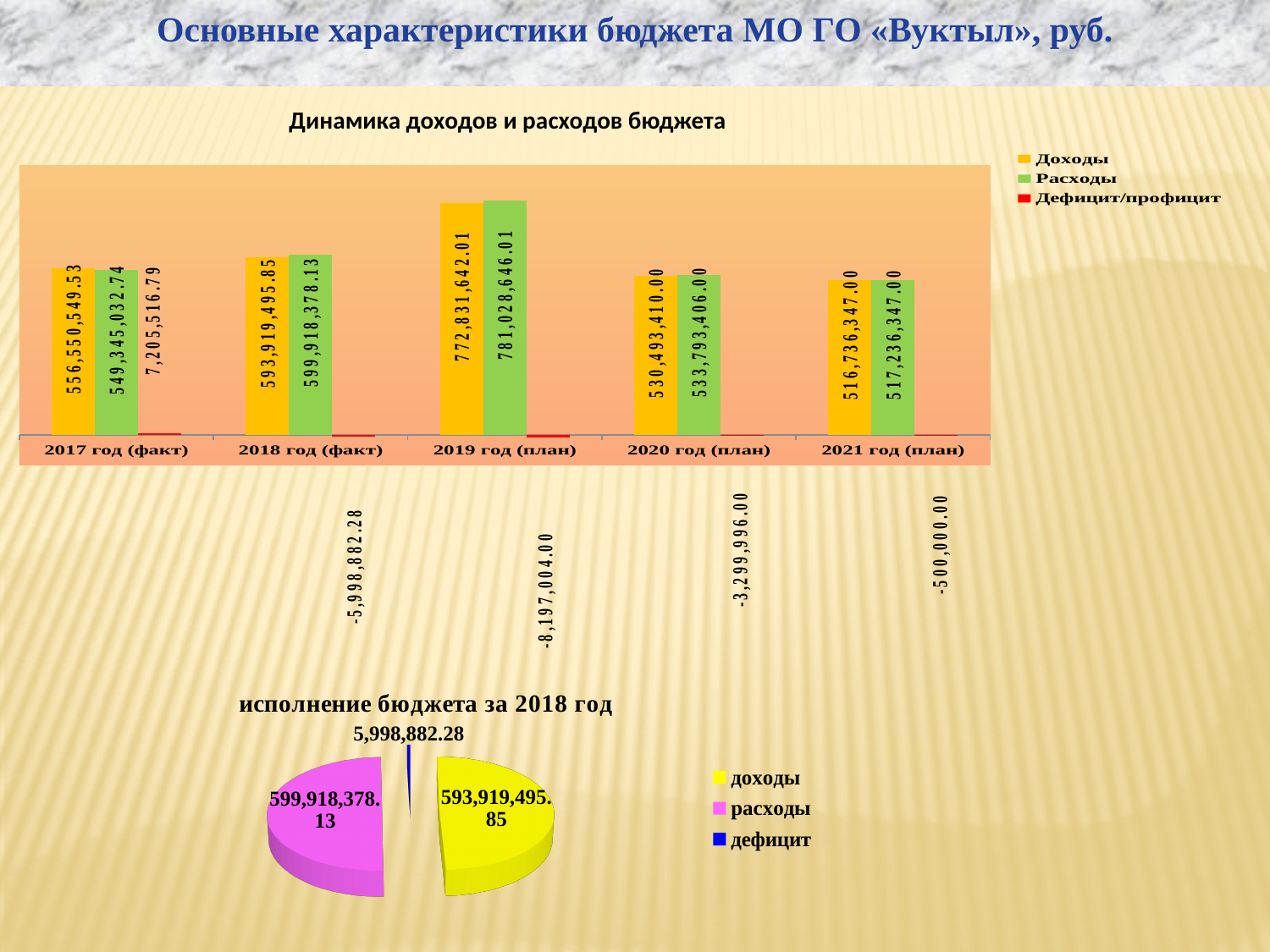
In the chart 'Динамика доходов и расходов бюджета', which year has the lowest Расходы? 2021 год (план) In the pie chart 'исполнение бюджета за 2018 год', what is the value of расходы? 599,918,378.13 What type of chart is 'исполнение бюджета за 2018 год'? pie chart In the chart 'Динамика доходов и расходов бюджета', what is the difference between Расходы and Доходы for 2021 год (план)? 500,000.00 In the chart 'Динамика доходов и расходов бюджета', which year has the highest Доходы? 2019 год (план) How many year categories are shown in the chart 'Динамика доходов и расходов бюджета'? 5 In the chart 'Динамика доходов и расходов бюджета', which is larger for 2017 год (факт): Доходы or Расходы? Доходы In the chart 'Динамика доходов и расходов бюджета', what is the value of Доходы for 2019 год (план)? 772,831,642.01 In the pie chart 'исполнение бюджета за 2018 год', which colour represents дефицит? blue In the chart 'Динамика доходов и расходов бюджета', what is the value of Расходы for 2017 год (факт)? 549,345,032.74 How many series does the legend of the chart 'Динамика доходов и расходов бюджета' list? 3 In the chart 'Динамика доходов и расходов бюджета', what is the value of Дефицит/профицит for 2020 год (план)? -3,299,996.00